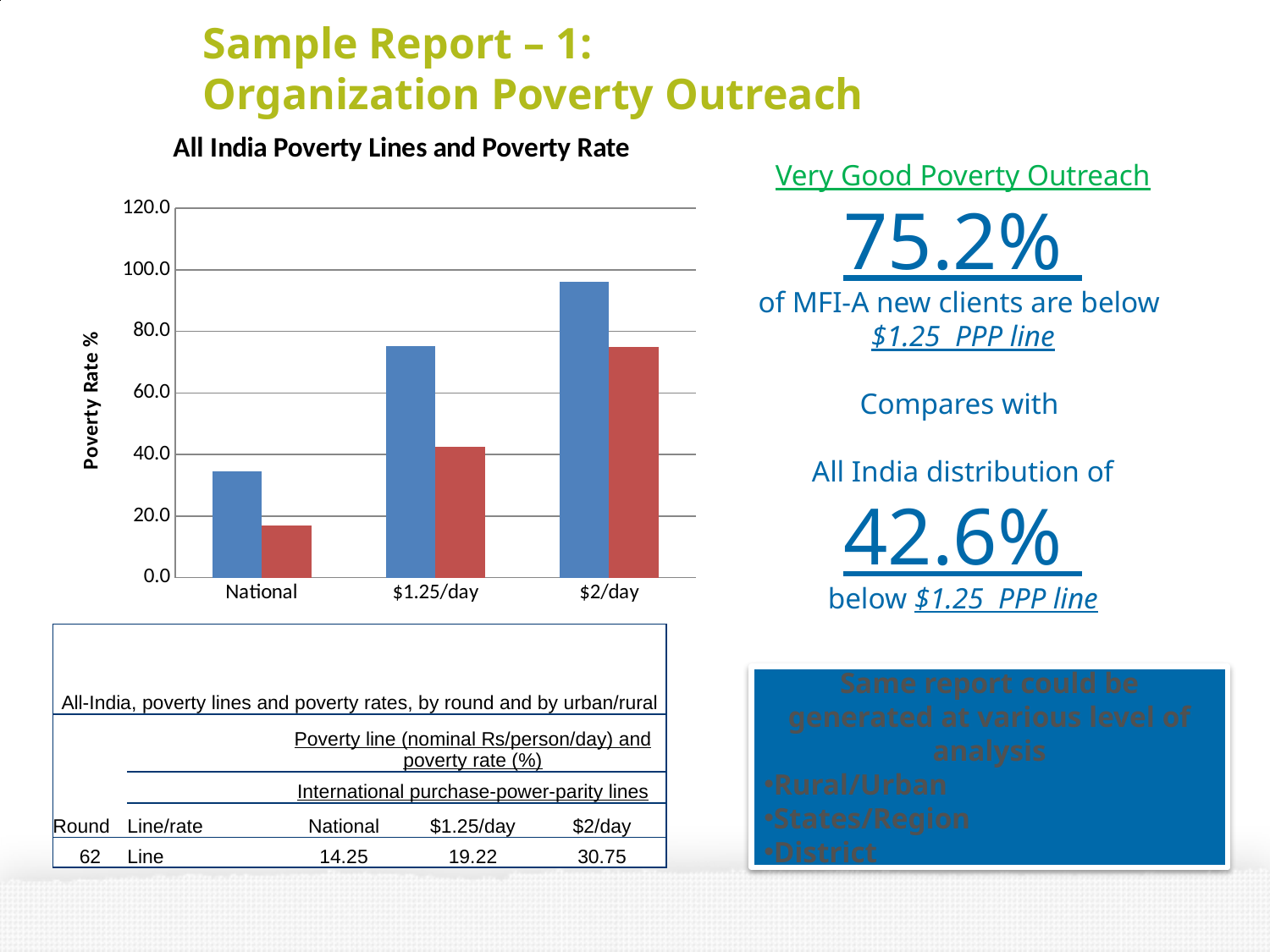
In the 'All India Poverty Lines and Poverty Rate' chart, is the red bar for National greater or less than 20.0? less In the 'All India Poverty Lines and Poverty Rate' chart, which is larger for the National category, the blue bar or the red bar? the blue bar Which category has the tallest blue bar in the 'All India Poverty Lines and Poverty Rate' chart? $2/day In the 'All India Poverty Lines and Poverty Rate' chart, is the blue bar for $1.25/day greater or less than 60.0? greater In the 'All India Poverty Lines and Poverty Rate' chart, is the red bar for $2/day greater or less than 100.0? less What is the highest tick value shown on the vertical axis of the 'All India Poverty Lines and Poverty Rate' chart? 120.0 What kind of chart is shown under the title 'All India Poverty Lines and Poverty Rate'? bar chart How many categories are shown on the x axis of the 'All India Poverty Lines and Poverty Rate' chart? 3 Which category has the shortest red bar in the 'All India Poverty Lines and Poverty Rate' chart? National What is the label on the vertical axis of the 'All India Poverty Lines and Poverty Rate' chart? Poverty Rate % Do the blue bars in the 'All India Poverty Lines and Poverty Rate' chart rise or fall from National to $2/day? rise